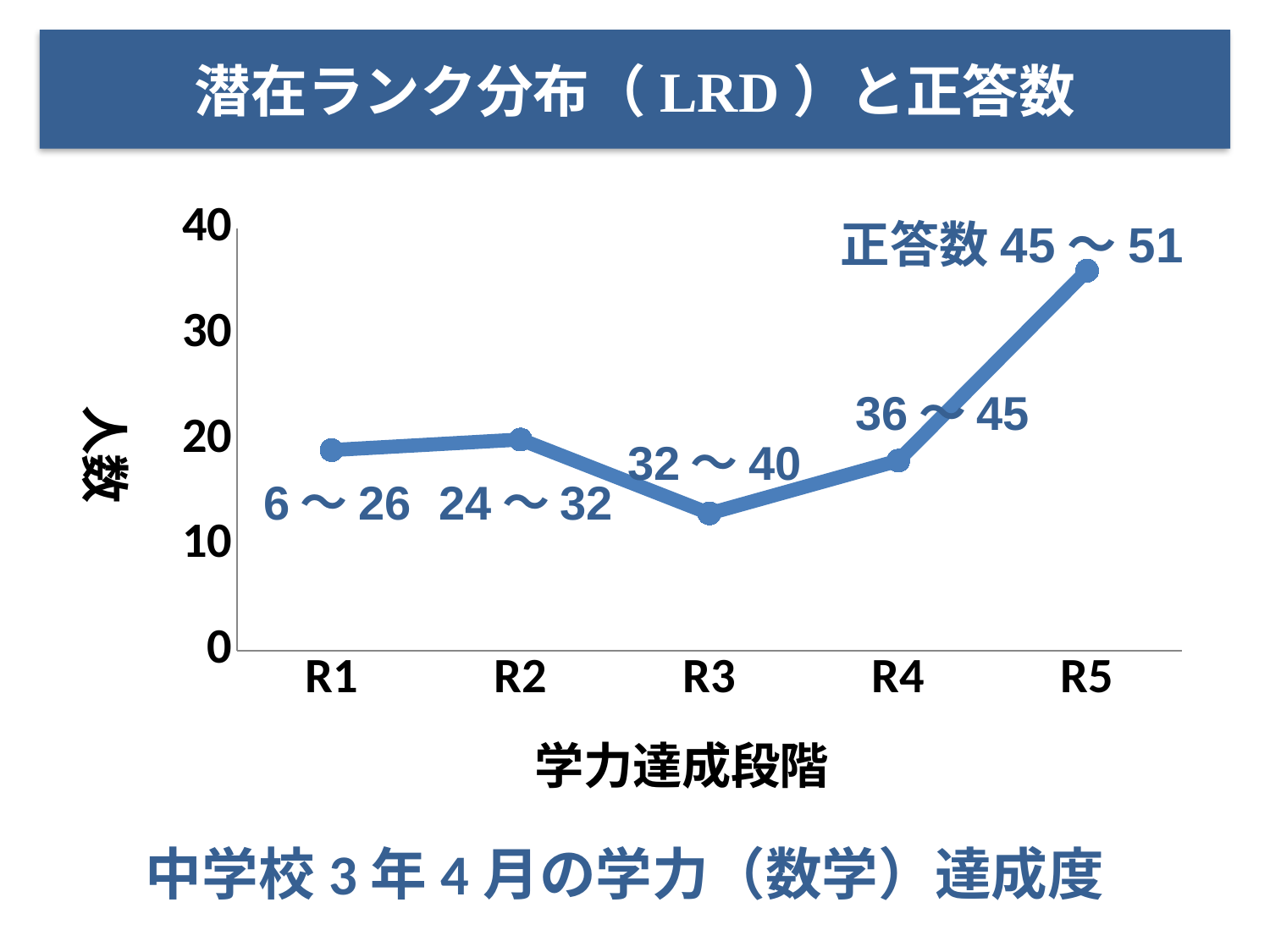
How many categories (学力達成段階) are plotted along the x axis? 5 Which category has the highest 人数? R5 Is the value for R3 greater or less than 20? less Does the line rise or fall between R4 and R5? rise Which category has the lowest 人数? R3 Is the value for R3 greater or less than 10? greater What is the title of the chart? 潜在ランク分布（LRD）と正答数 Is the value for R5 greater or less than 30? greater Which is larger, the value for R2 or the value for R3? R2 What 正答数 range is annotated next to the R5 point? 45 〜 51 What kind of chart is shown on the slide? line chart Which is larger, the value for R5 or the value for R4? R5